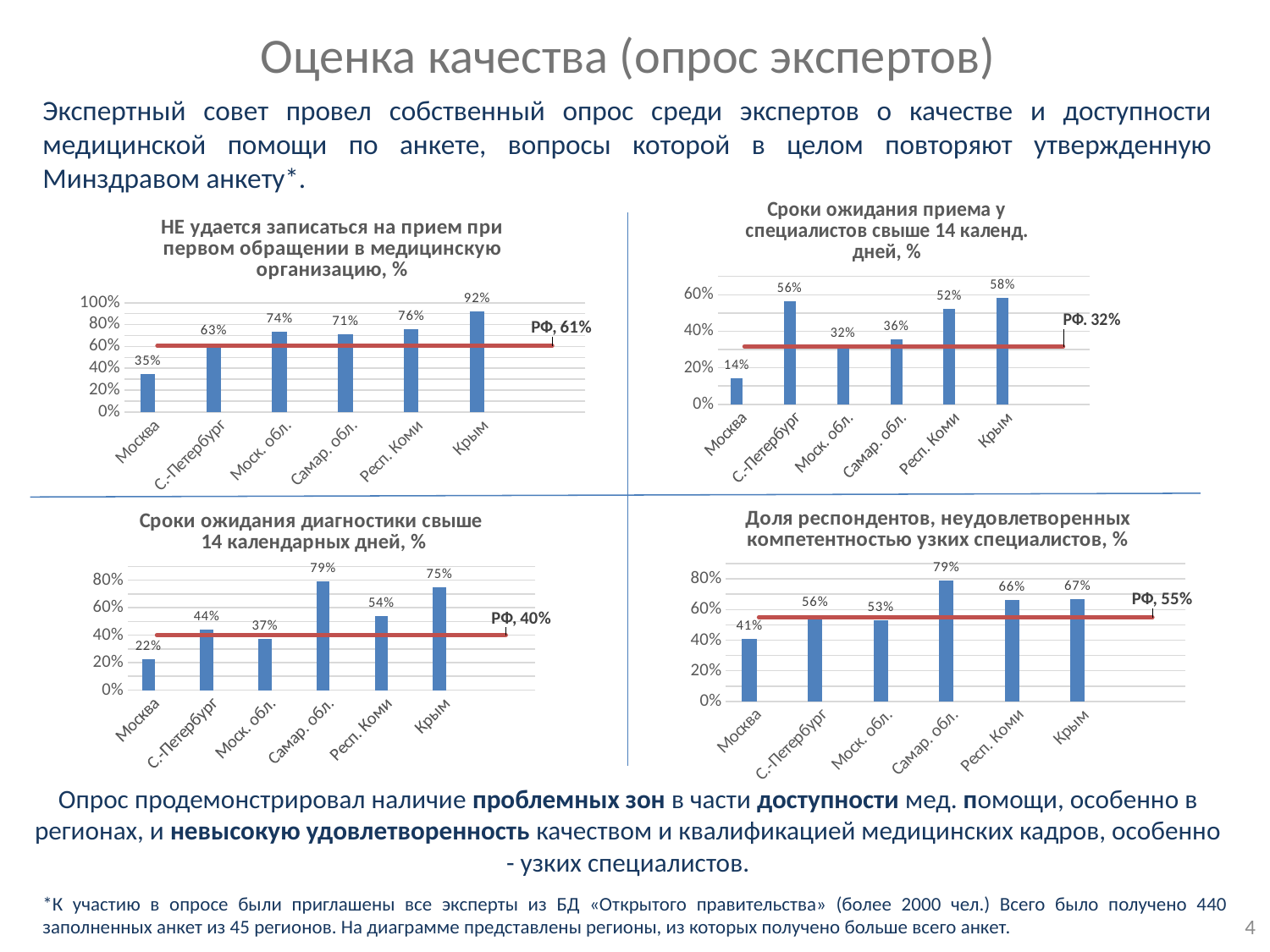
In the top-right chart (Сроки ожидания приема у специалистов свыше 14 календ. дней, %), which region has the highest value? Крым In the bottom-left chart (Сроки ожидания диагностики свыше 14 календарных дней, %), which is larger: Респ. Коми or Крым? Крым In the top-right chart (Сроки ожидания приема у специалистов свыше 14 календ. дней, %), what is the difference between С.-Петербург and Моск. обл.? 24% In the top-left chart (НЕ удается записаться на прием при первом обращении в медицинскую организацию, %), what is the value for Крым? 92% In the bottom-right chart (Доля респондентов, неудовлетворенных компетентностью узких специалистов, %), what is the value for Респ. Коми? 66% In the bottom-left chart (Сроки ожидания диагностики свыше 14 календарных дней, %), how many regions are shown? 6 What type of chart is the bottom-right chart (Доля респондентов, неудовлетворенных компетентностью узких специалистов, %)? Bar chart In the top-left chart (НЕ удается записаться на прием при первом обращении в медицинскую организацию, %), which region has the lowest value? Москва In the bottom-left chart (Сроки ожидания диагностики свыше 14 календарных дней, %), what is the value for Самар. обл.? 79% In the top-right chart (Сроки ожидания приема у специалистов свыше 14 календ. дней, %), what is the value for Москва? 14% In the bottom-right chart (Доля респондентов, неудовлетворенных компетентностью узких специалистов, %), what is the difference between Самар. обл. and Москва? 38% In the top-left chart (НЕ удается записаться на прием при первом обращении в медицинскую организацию, %), what is the РФ reference value shown by the red line? 61%